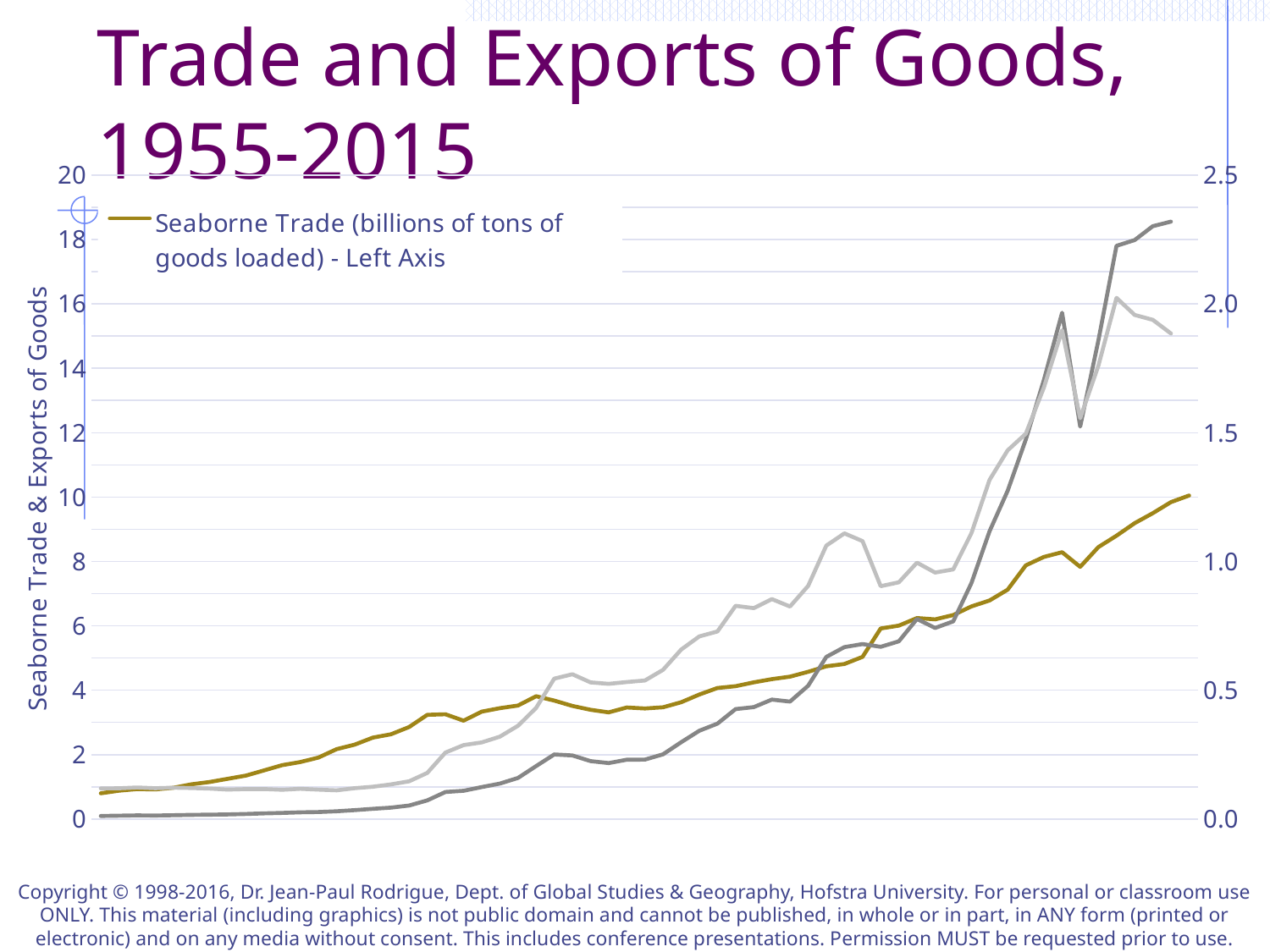
Is the Seaborne Trade value at the rightmost point of the chart greater or less than 6? greater Is the Seaborne Trade value at the rightmost point of the chart greater or less than 8? greater What is the title of the chart on the slide? Trade and Exports of Goods, 1955-2015 How many lines are plotted on the chart? 3 Does the Seaborne Trade line rise or fall from left to right across the chart? rise Is the highest value reached by the Seaborne Trade line greater or less than 12? less What kind of chart is shown on the slide? line chart On which axis is the Seaborne Trade series plotted? Left Axis